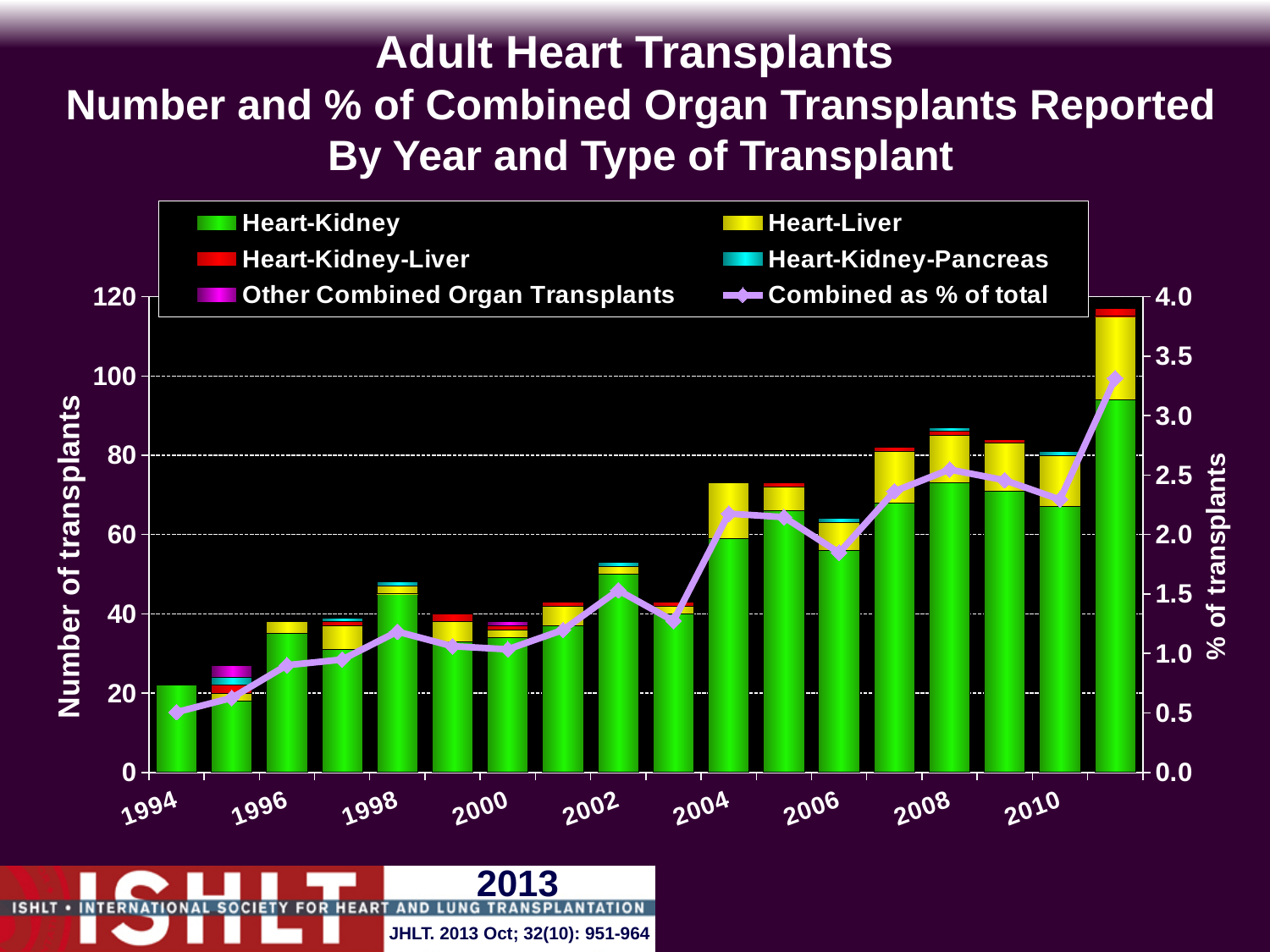
What is the title of the right-hand vertical axis? % of transplants How many entries does the legend list? 6 Which year has a larger total number of transplants, 2004 or 2006? 2004 How many years (bars) are plotted along the x axis? 18 Is the total number of transplants for 1994 greater or less than 40? less Is the total number of transplants for 2011 greater or less than 100? greater Is the total number of transplants for 2004 greater or less than 60? greater Overall, do the total numbers of combined organ transplants rise or fall from 1994 to 2011? rise What kind of chart is shown on the slide? combination bar and line chart Which year has the lowest total number of combined organ transplants? 1994 Which year has the highest total number of combined organ transplants? 2011